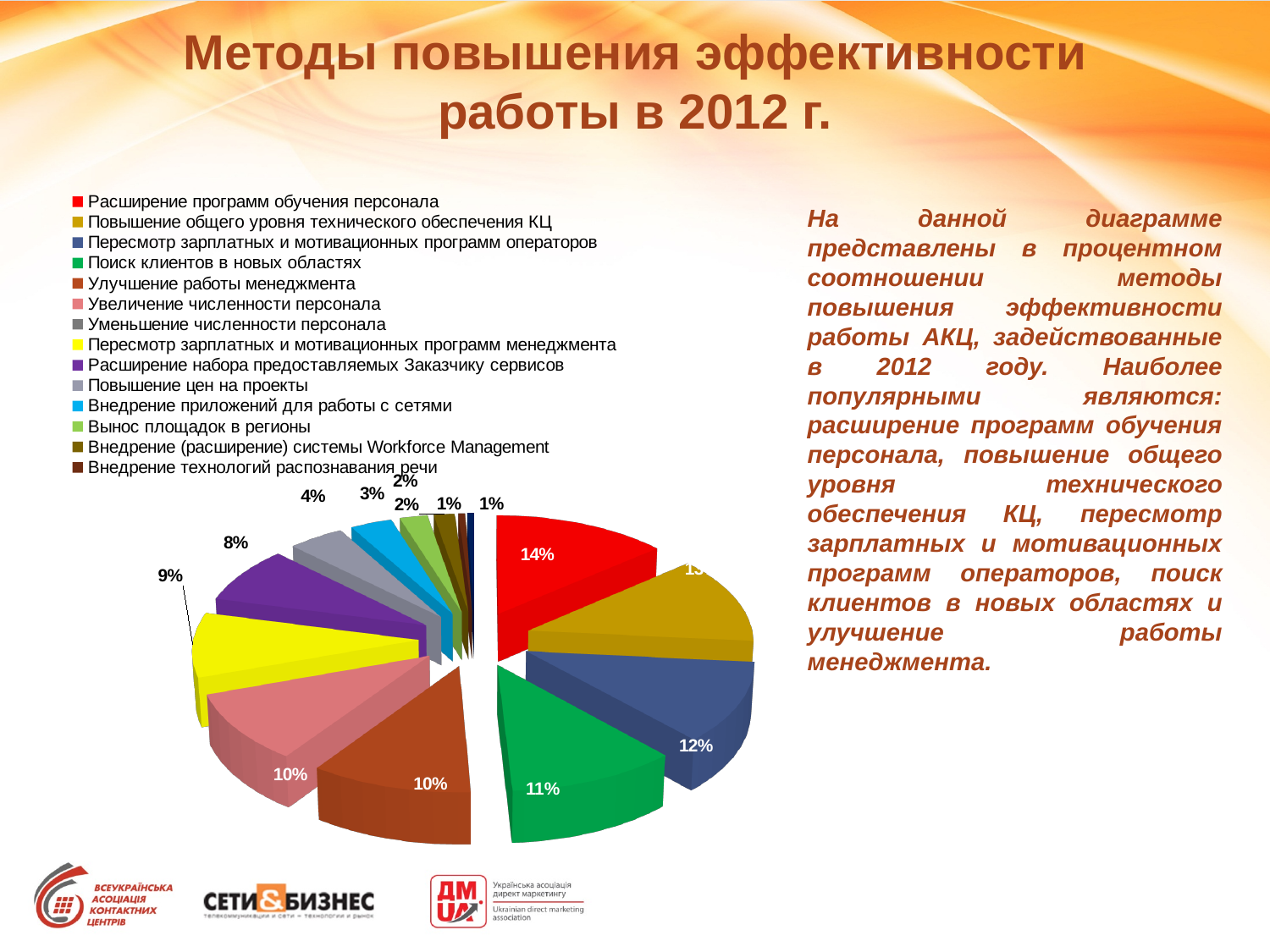
What share of the pie does "Поиск клиентов в новых областях" have? 11% What share of the pie does "Пересмотр зарплатных и мотивационных программ менеджмента" have? 9% How many categories does the legend list? 14 What share of the pie does "Расширение набора предоставляемых Заказчику сервисов" have? 8% What share of the pie does "Улучшение работы менеджмента" have? 10% What is the title of the slide containing the chart? Методы повышения эффективности работы в 2012 г. Which is larger: the slice for "Поиск клиентов в новых областях" or the slice for "Расширение набора предоставляемых Заказчику сервисов"? Поиск клиентов в новых областях What kind of chart is shown on the slide? pie chart Which category has the largest slice of the pie? Расширение программ обучения персонала What is the difference in percentage points between "Расширение программ обучения персонала" and "Пересмотр зарплатных и мотивационных программ операторов"? 2 percentage points What share of the pie does "Пересмотр зарплатных и мотивационных программ операторов" have? 12% What share of the pie does "Расширение программ обучения персонала" have? 14%